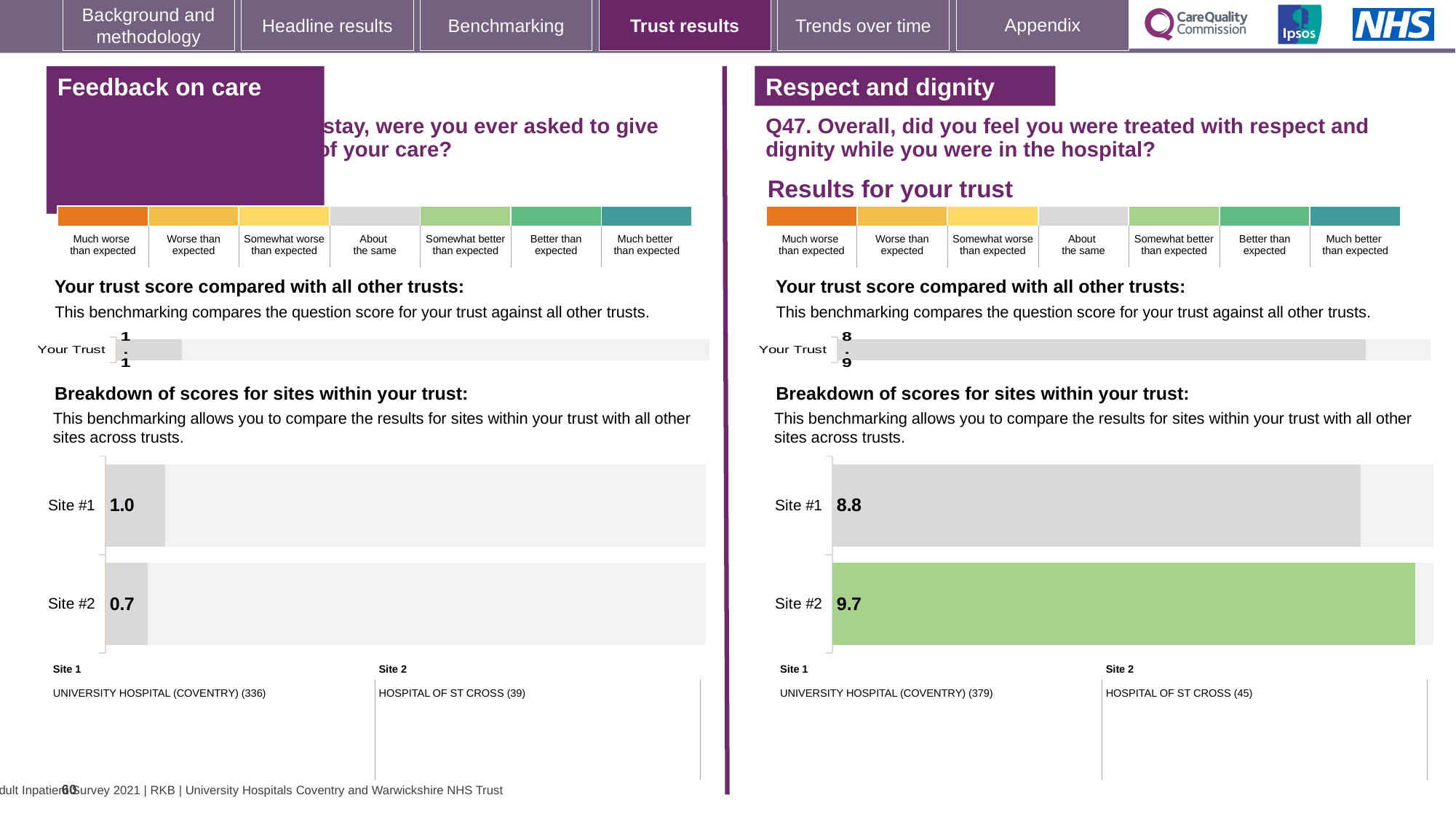
What type of chart is the 'Feedback on care' site breakdown chart on the left? Bar chart In the 'Feedback on care' trust score chart on the left, what is the value shown for Your Trust? 1.1 How many sites are shown in the 'Respect and dignity' site breakdown chart on the right? 2 In the 'Respect and dignity' site breakdown chart on the right, what is the score for Site #1? 8.8 In the 'Feedback on care' site breakdown chart on the left, which site has the lowest score? Site #2 In the 'Feedback on care' site breakdown chart on the left, what is the score for Site #2? 0.7 In the 'Respect and dignity' site breakdown chart on the right, what is the difference between the Site #2 and Site #1 scores? 0.9 In the 'Feedback on care' site breakdown chart on the left, what is the difference between the Site #1 and Site #2 scores? 0.3 In the 'Respect and dignity' site breakdown chart on the right, what is the score for Site #2? 9.7 In the 'Respect and dignity' trust score chart on the right, what is the value shown for Your Trust? 8.9 In the 'Feedback on care' site breakdown chart on the left, what is the score for Site #1? 1.0 In the 'Respect and dignity' site breakdown chart on the right, which site has the highest score? Site #2